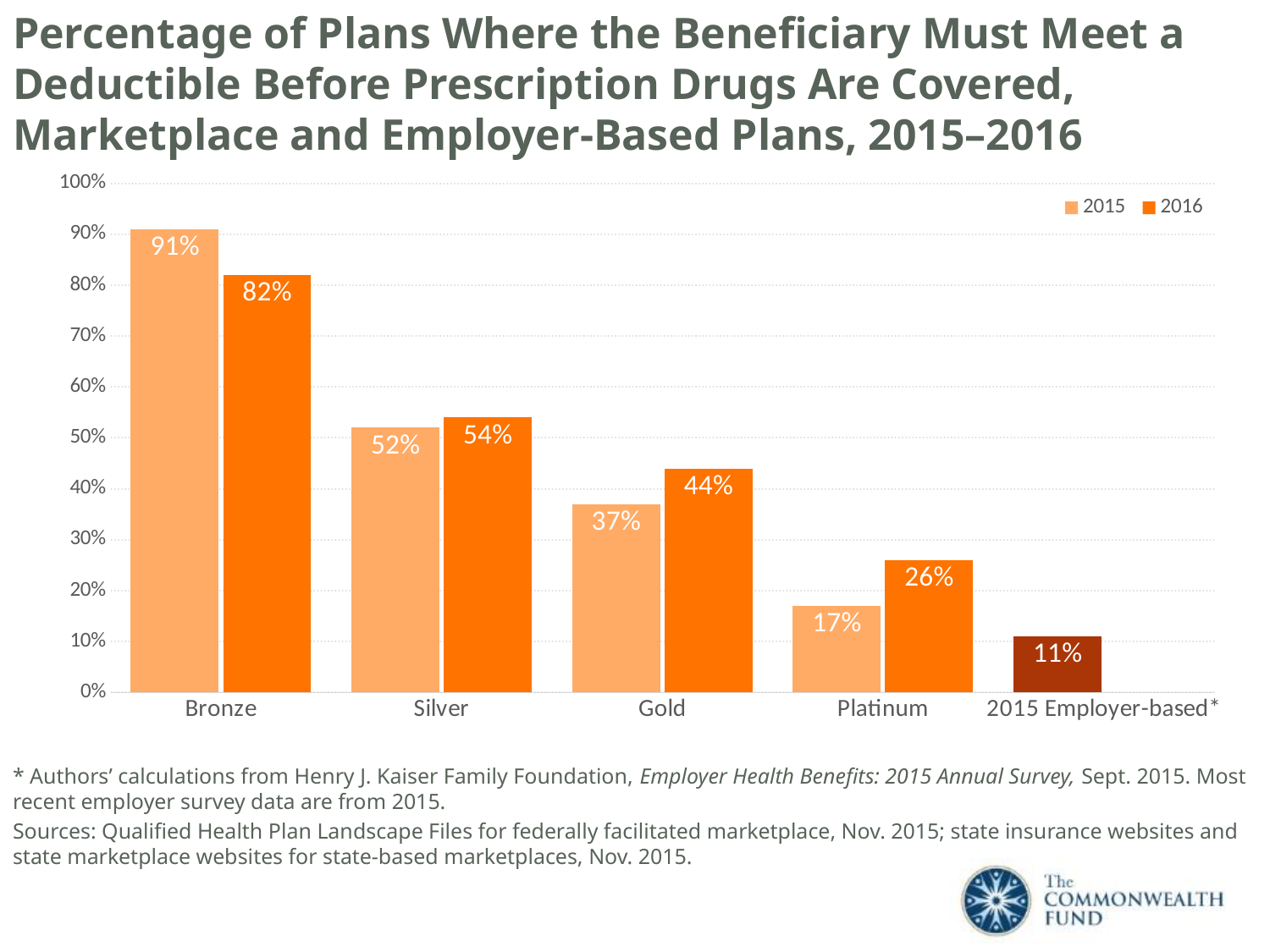
How many categories are shown on the x axis? 5 What kind of chart is shown on the slide? Bar chart Which category has the highest 2016 value? Bronze What is the value shown for 2015 Employer-based plans? 11% What is the 2015 value for Bronze plans? 91% Which is larger for Silver plans, the 2015 value or the 2016 value? 2016 Do the 2016 values rise or fall from Bronze to Platinum? Fall What is the difference between the 2015 and 2016 values for Bronze plans? 9 percentage points What is the difference between the 2015 and 2016 values for Platinum plans? 9 percentage points Which marketplace plan tier has the lowest 2015 value? Platinum What is the 2016 value for Gold plans? 44% How many series does the legend list? 2